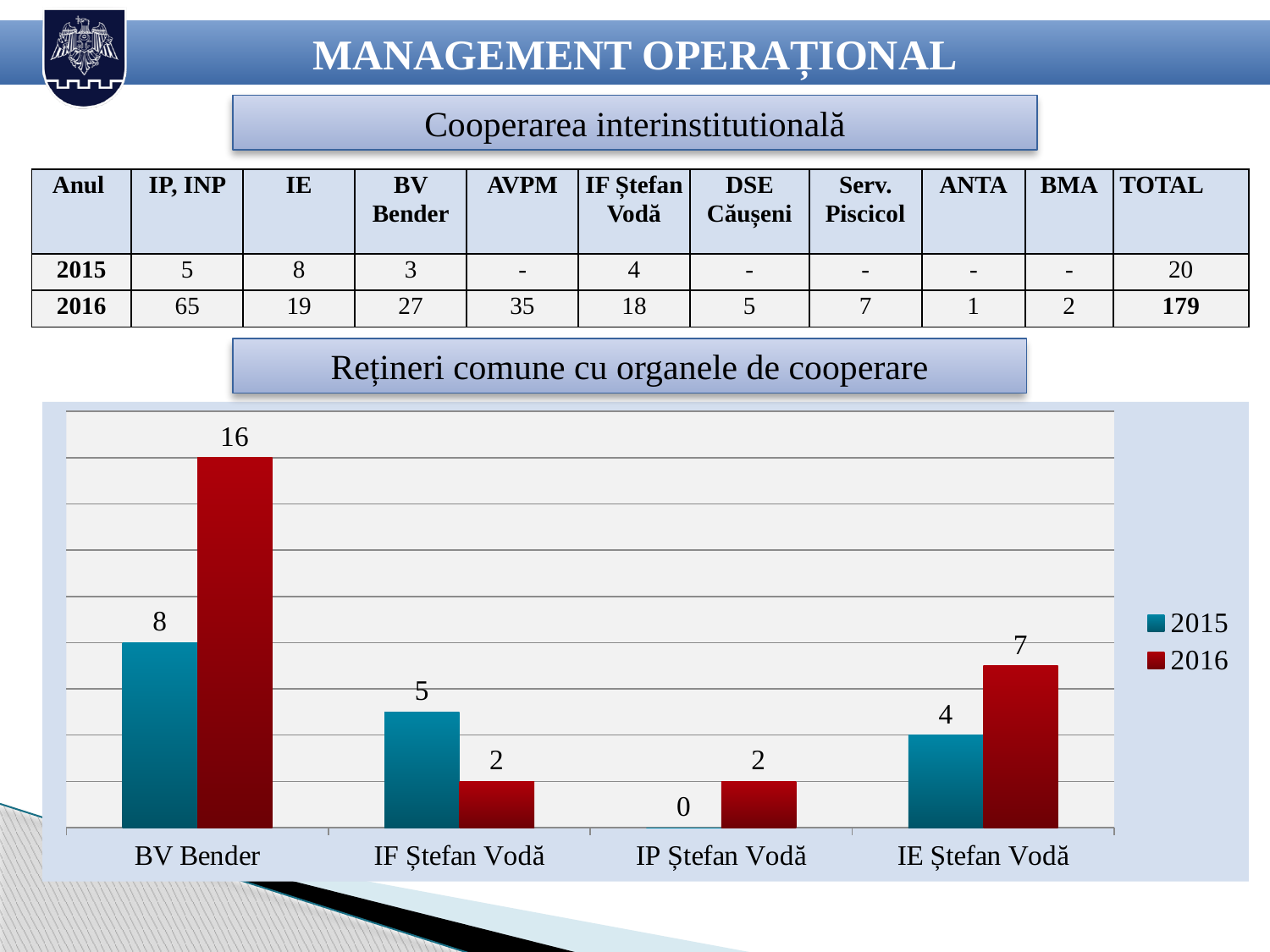
How many series does the legend of the bar chart list? 2 What is the difference between the 2016 and 2015 values for BV Bender in the bar chart? 8 What is the 2015 value for IF Ștefan Vodă in the bar chart? 5 Which category has the highest 2016 value in the bar chart? BV Bender What is the 2016 value for IE Ștefan Vodă in the bar chart? 7 Which category has the lowest 2015 value in the bar chart? IP Ștefan Vodă What kind of chart is shown on the slide? Bar chart What is the 2016 value for BV Bender in the bar chart? 16 How many categories are shown on the x axis of the bar chart? 4 In the bar chart, is the 2015 value for IF Ștefan Vodă larger or the 2016 value? 2015 What is the 2015 value for IP Ștefan Vodă in the bar chart? 0 Which series is shown in red in the bar chart? 2016